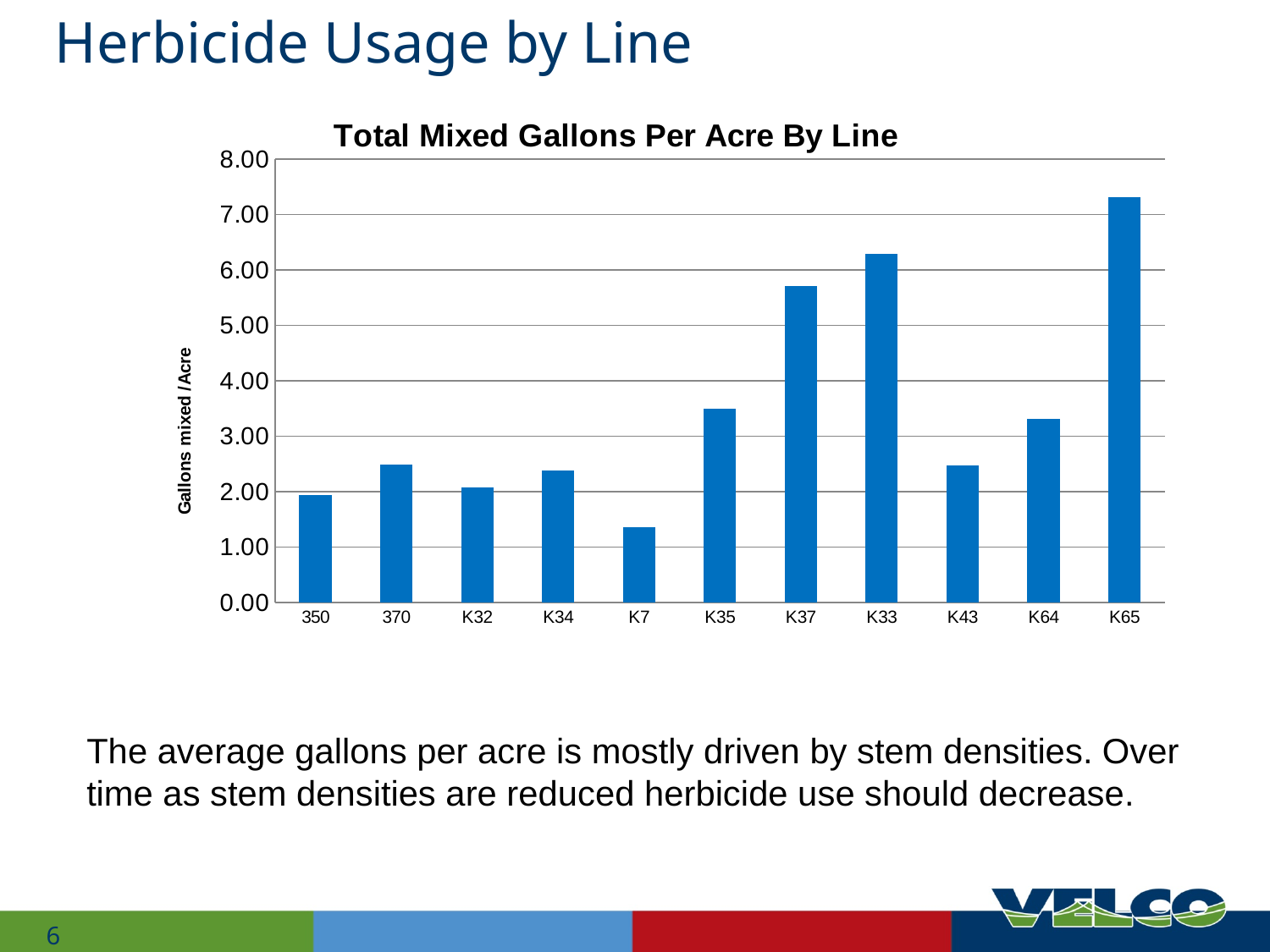
Is the value for K65 greater or less than 7.00? greater How many lines (categories) are shown on the x axis of the chart? 11 Is the value for K7 greater or less than 2.00? less Which line has the lowest total mixed gallons per acre? K7 Which line has the highest total mixed gallons per acre? K65 Which line has a higher value, K33 or K37? K33 Which line has a higher value, K37 or K64? K37 Is the value for K33 greater or less than 6.00? greater What is the label on the vertical axis of the chart? Gallons mixed /Acre What kind of chart is shown on the slide? Bar chart What is the title of the chart? Total Mixed Gallons Per Acre By Line